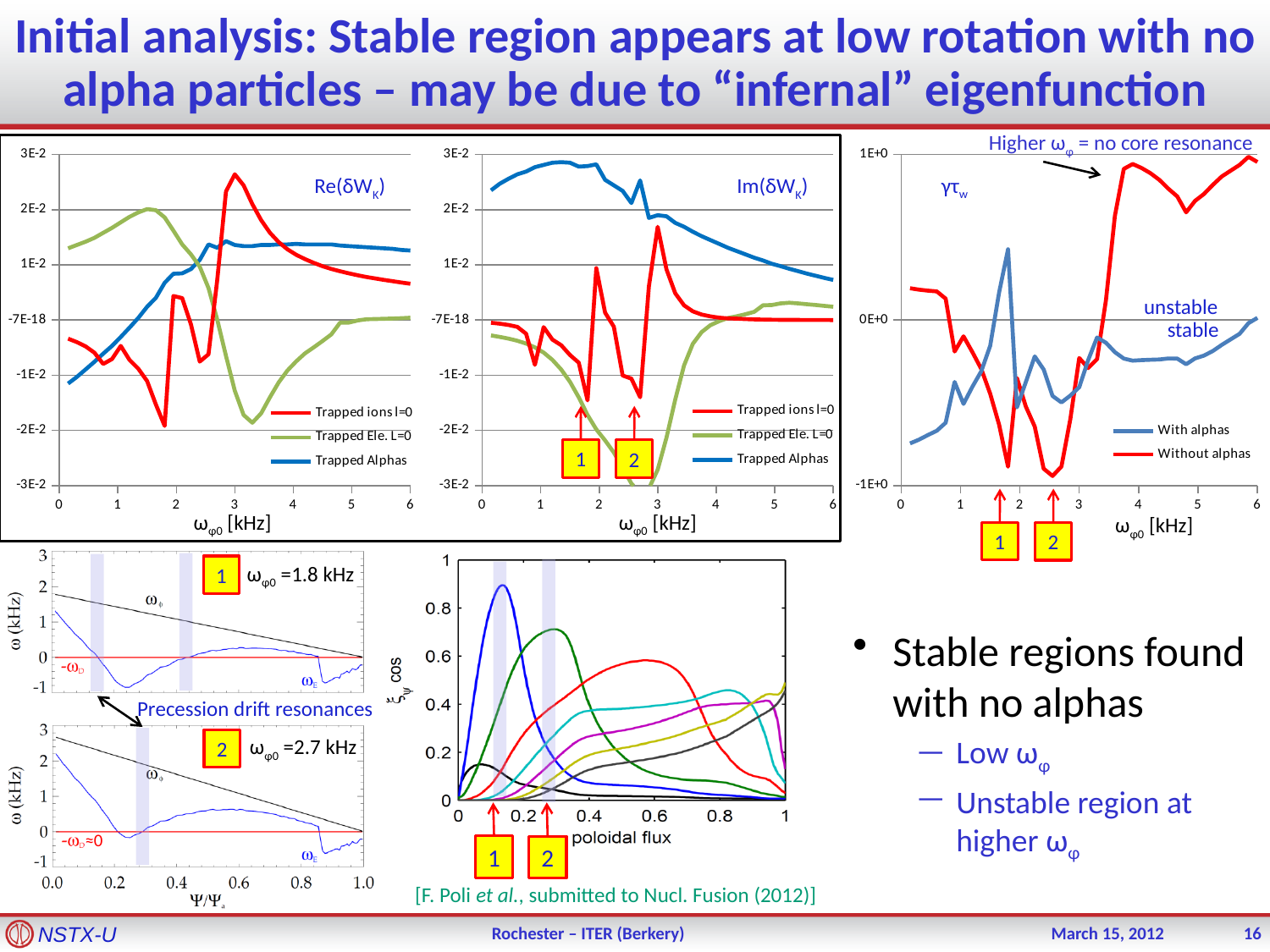
What kind of chart is the Re(δW_K) chart at the top left? line chart How many series does the legend of the γτ_w chart list? 2 In the γτ_w chart, is the value for Without alphas at ω_φ0 = 5 kHz greater or less than 0E+0? greater In the ξ_ψ cos versus poloidal flux chart, is the peak of the blue curve greater or less than 0.8? greater In the γτ_w chart, which series is larger at ω_φ0 = 6 kHz, With alphas or Without alphas? Without alphas In the Im(δW_K) chart, which series reaches the lowest value over the plotted range? Trapped Ele. L=0 In the γτ_w chart, is the value for With alphas at ω_φ0 = 0.2 kHz greater or less than 0E+0? less How many series does the legend of the Re(δW_K) chart list? 3 In the γτ_w chart, does the Without alphas curve rise or fall between ω_φ0 = 3 kHz and ω_φ0 = 4 kHz? rise In the Im(δW_K) chart, which series has the highest value at ω_φ0 = 1 kHz? Trapped Alphas In the Re(δW_K) chart, which series does the legend show in blue? Trapped Alphas